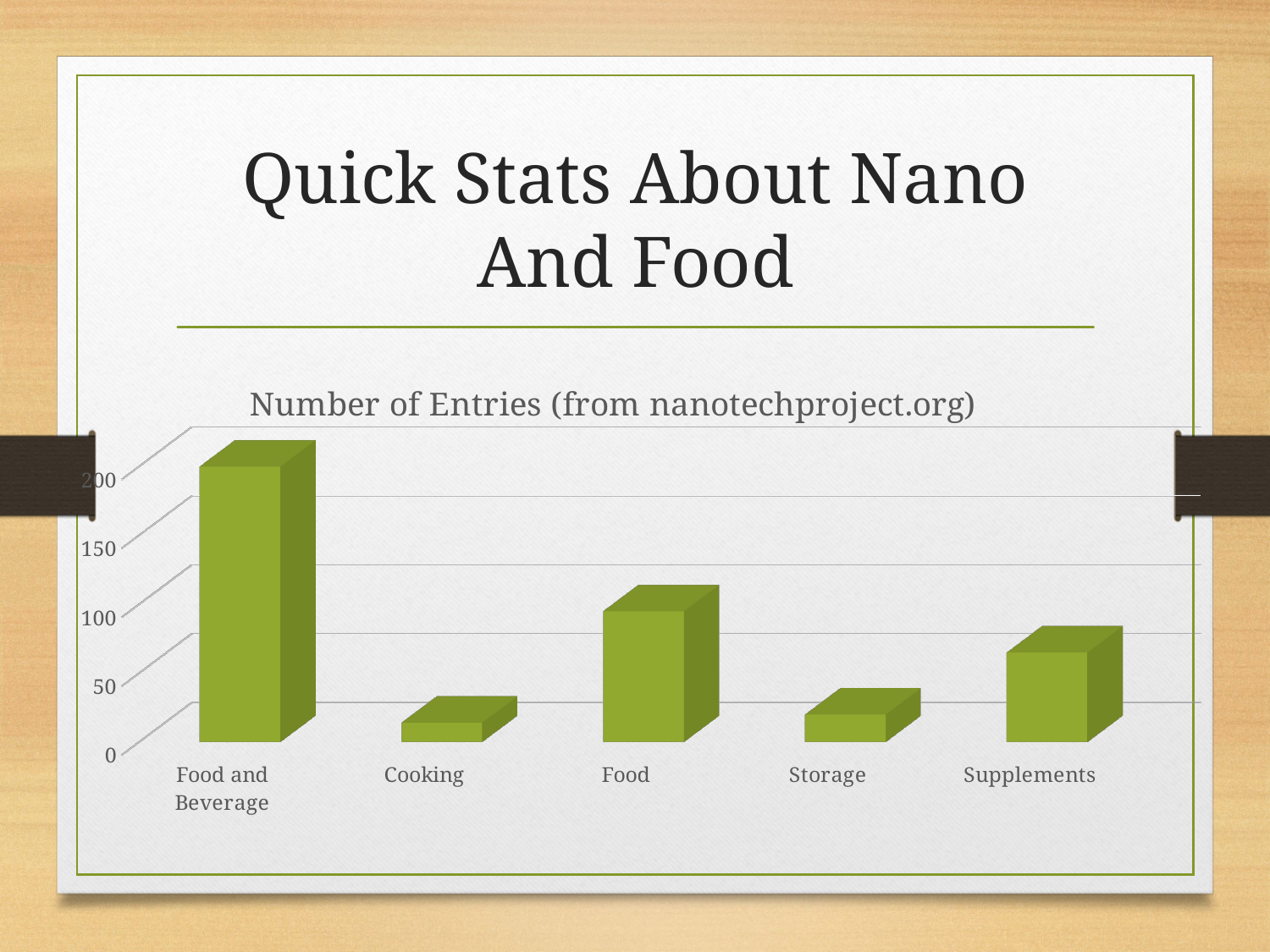
Which has more entries, Food or Supplements? Food Is the value for Food greater or less than 150? less Is the value for Food and Beverage greater or less than 150? greater What is the title of the chart? Number of Entries (from nanotechproject.org) Is the value for Supplements greater or less than 100? less What type of chart is shown on the slide? Bar chart Which category has the lowest number of entries? Cooking What colour are the bars in the chart? Green How many categories are shown on the x axis of the chart? 5 Which category has the highest number of entries? Food and Beverage